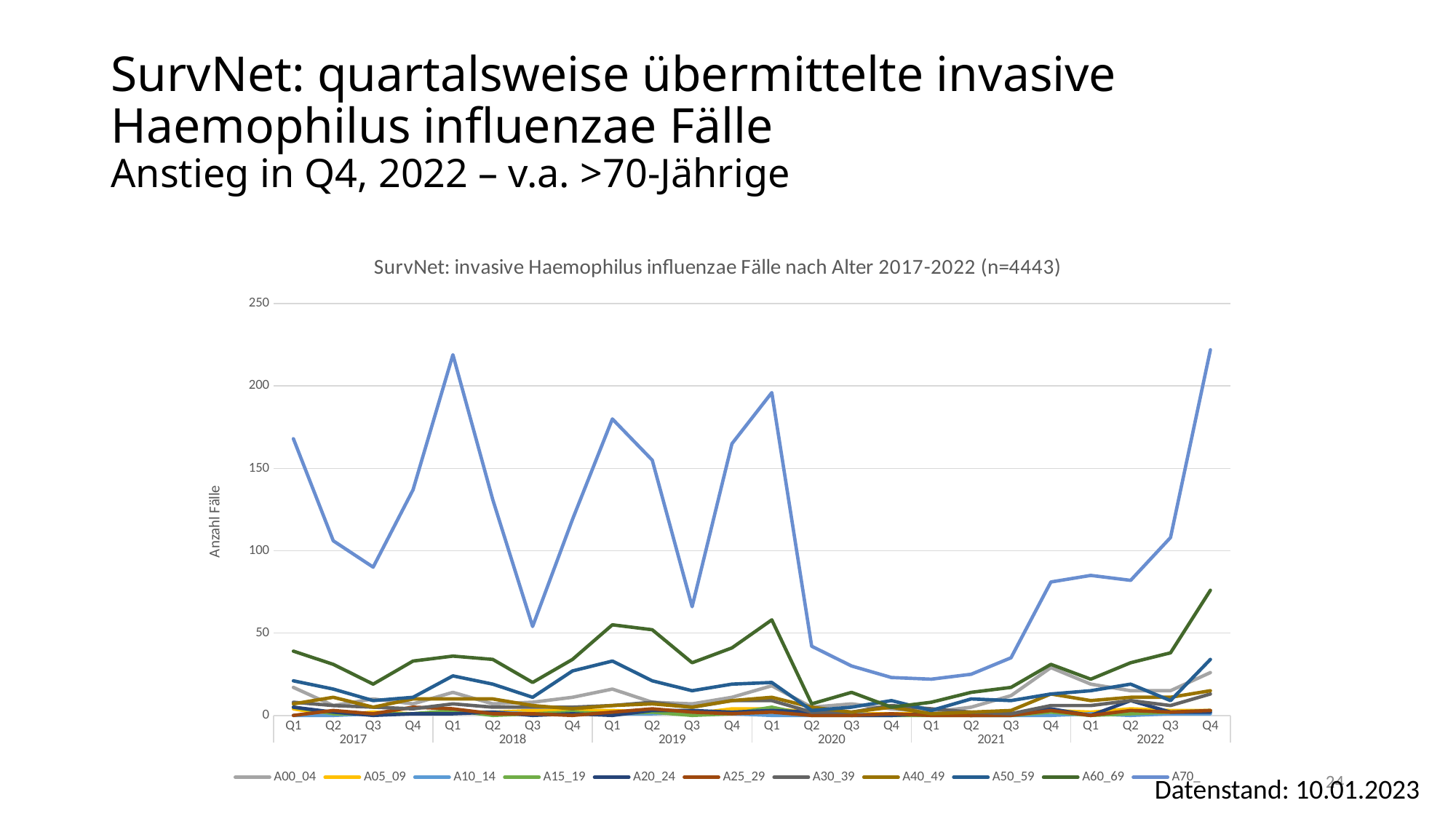
Which series has the highest value in Q4 2022? A70_ Is the value for A70_ in Q3 2018 greater or less than 100? less How many series does the legend list? 11 What is the label of the y axis? Anzahl Fälle How many quarterly data points are plotted along the x axis? 24 What kind of chart is shown on the slide? line chart Is the value for A70_ in Q4 2022 greater or less than 200? greater From Q1 2021 to Q4 2022, does the A70_ series generally rise or fall? rise Is the value for A60_69 in Q4 2022 greater or less than 50? greater Which is larger for A70_: the value in Q1 2017 or the value in Q3 2017? Q1 2017